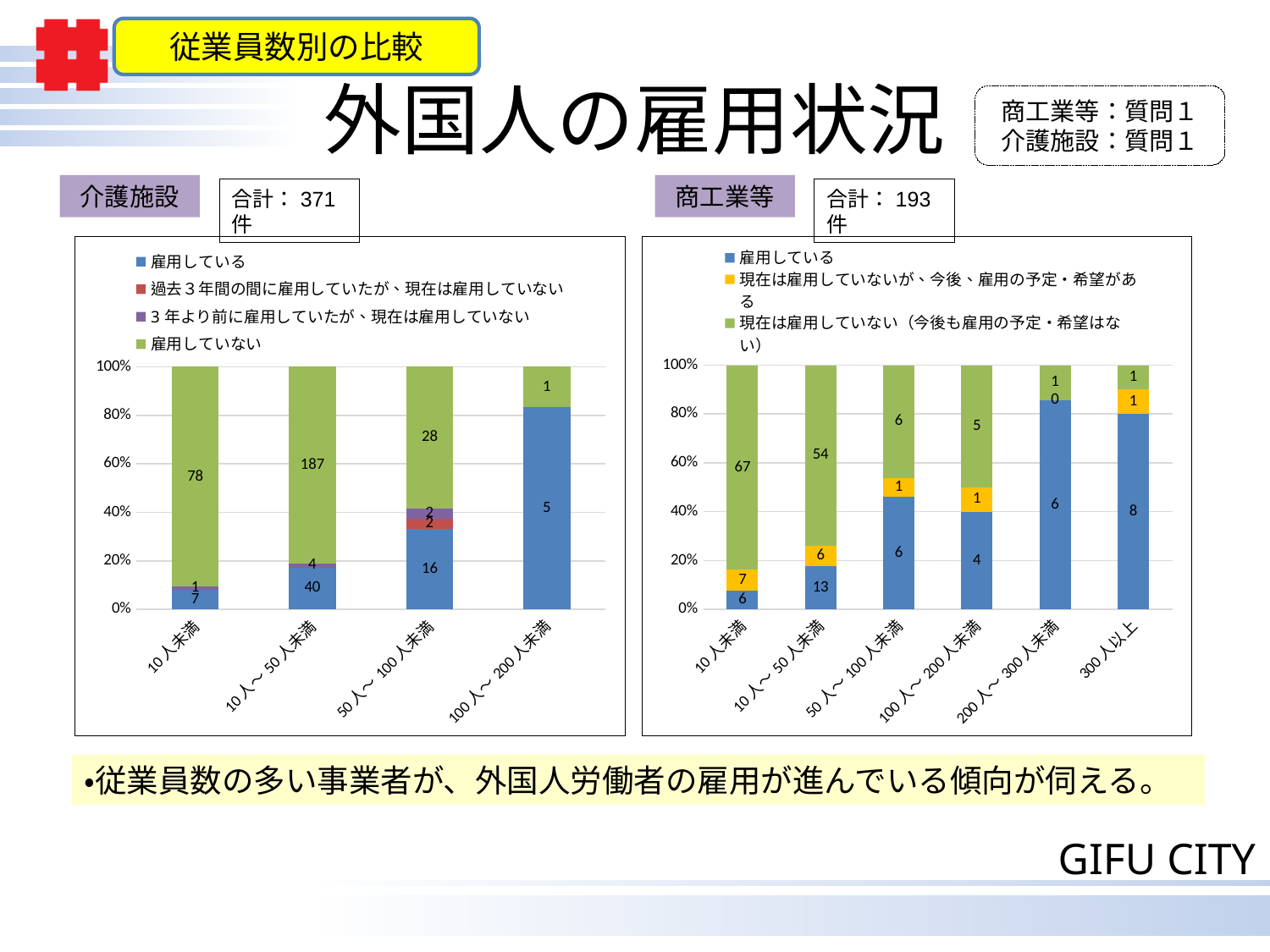
In the 介護施設 chart, what is the value of 雇用している for 50人～100人未満? 16 In the 商工業等 chart, how many categories are shown on the x axis? 6 In the 介護施設 chart, what is the value of 雇用していない for 10人～50人未満? 187 In the 介護施設 chart, how many categories are shown on the x axis? 4 In the 介護施設 chart, what is the difference between 雇用していない for 10人未満 and 雇用している for 10人未満? 71 In the 商工業等 chart, what is the total of the stacked bar for 50人～100人未満? 13 In the 介護施設 chart, which category has the highest value for 雇用している? 10人～50人未満 In the 商工業等 chart, what is the value of 雇用している for 300人以上? 8 What kind of chart is the 商工業等 chart? Stacked bar chart In the 商工業等 chart, what is the value of 現在は雇用していない（今後も雇用の予定・希望はない） for 10人未満? 67 In the 商工業等 chart, which is larger: 雇用している for 10人～50人未満 or 雇用している for 100人～200人未満? 10人～50人未満 In the 介護施設 chart, how many series does the legend list? 4